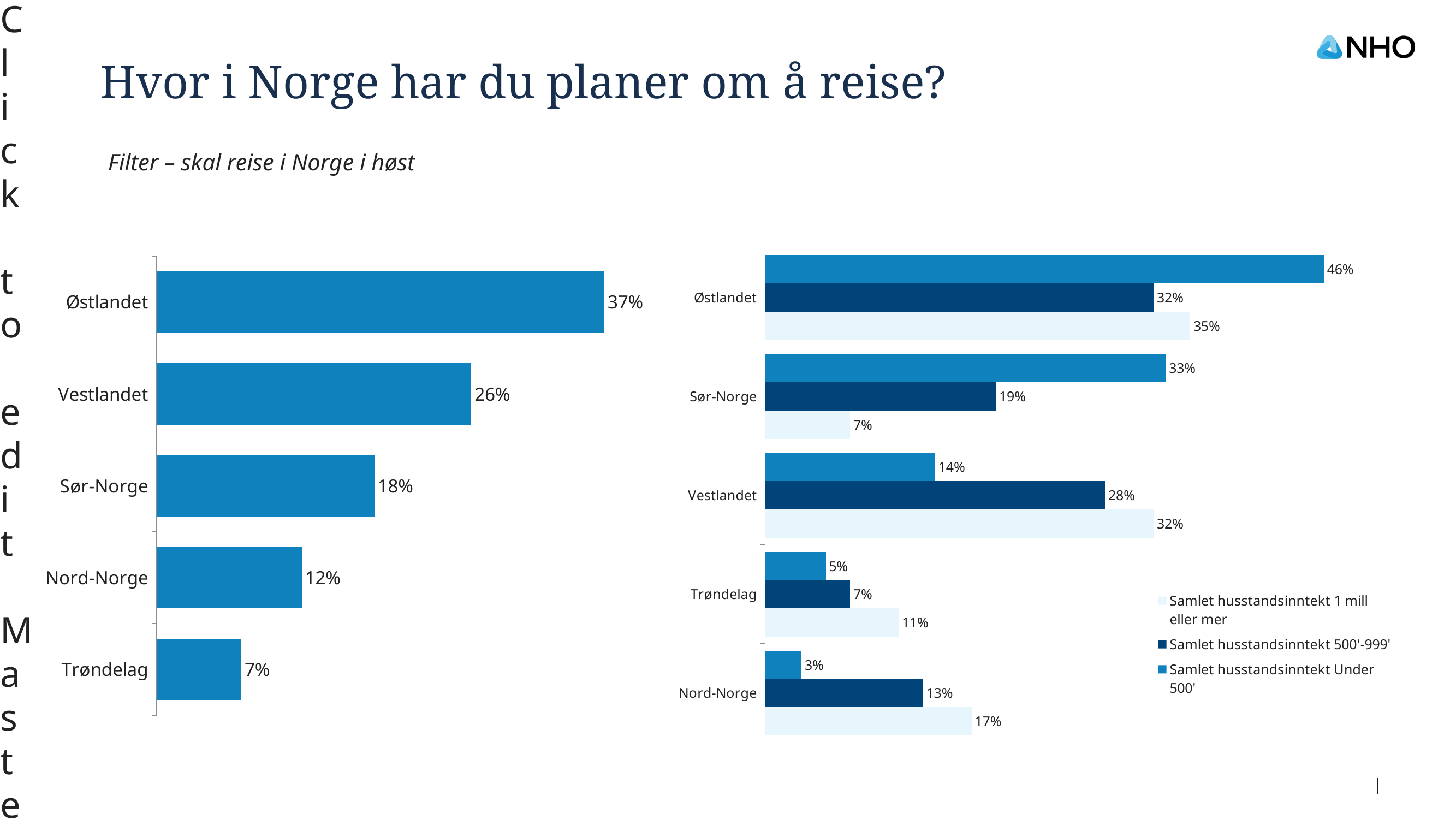
In the left chart, what is the value for Vestlandet? 26% How many regions are shown in the left chart? 5 In the right chart, which is larger for Sør-Norge: the value for 'Samlet husstandsinntekt 500'-999'' or for 'Samlet husstandsinntekt 1 mill eller mer'? Samlet husstandsinntekt 500'-999' In the right chart, what is the value for Vestlandet in the series 'Samlet husstandsinntekt 1 mill eller mer'? 32% In the right chart, what is the difference between the 'Samlet husstandsinntekt Under 500'' values for Østlandet and Nord-Norge? 43 percentage points What kind of chart is the left chart? Bar chart In the right chart, what is the value for Østlandet in the series 'Samlet husstandsinntekt Under 500''? 46% In the left chart, which region has the lowest value? Trøndelag In the left chart, what is the difference between the values for Østlandet and Sør-Norge? 19 percentage points How many series does the legend of the right chart list? 3 In the left chart, which region has the highest value? Østlandet In the right chart, which region has the lowest value in the series 'Samlet husstandsinntekt Under 500''? Nord-Norge